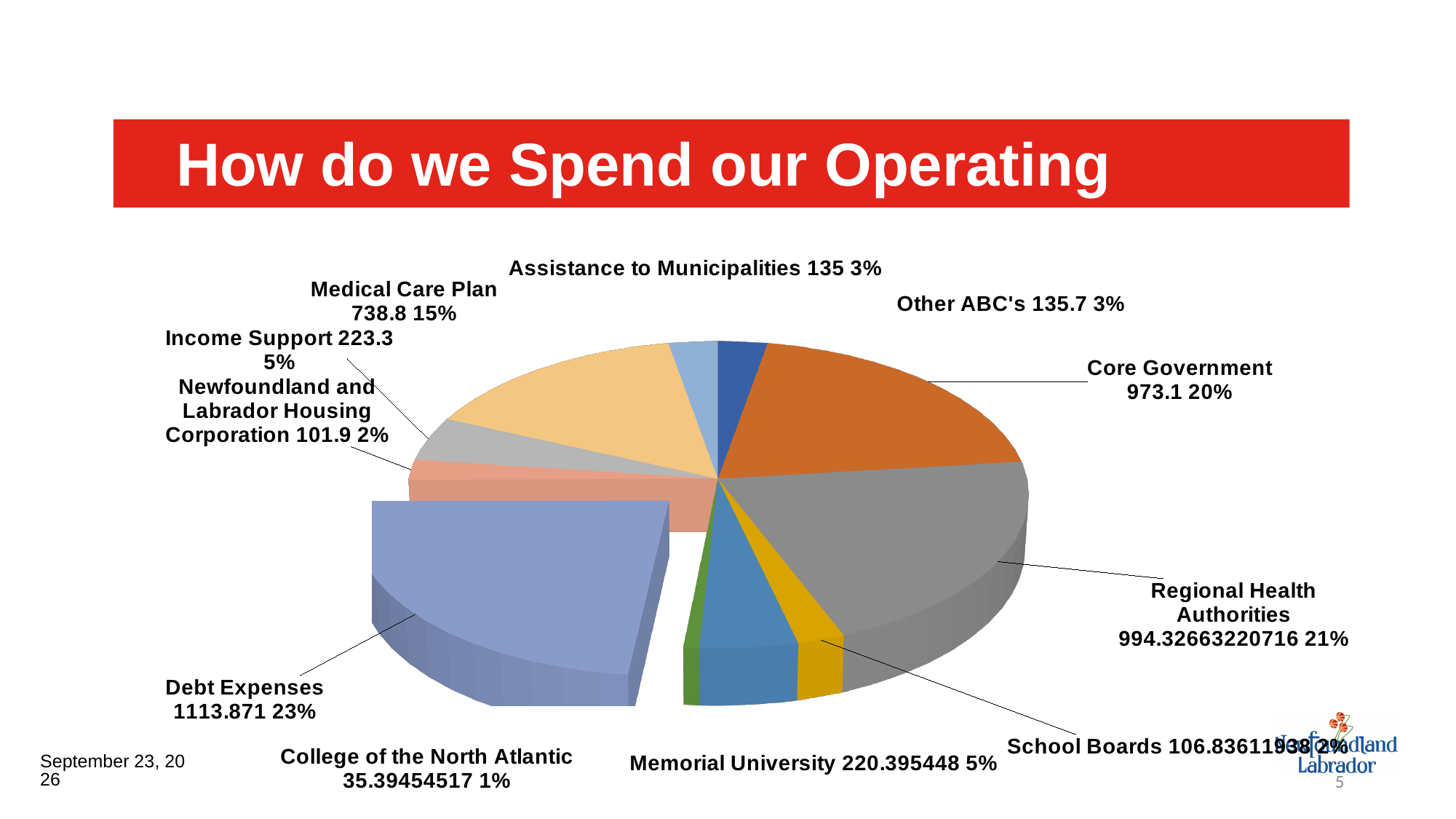
Which category has the largest slice of the pie chart? Debt Expenses What is the difference between the Debt Expenses value and the Core Government value? 140.771 Which category has the smallest slice of the pie chart? College of the North Atlantic What share of the pie does Medical Care Plan represent? 15% How many categories (slices) does the pie chart show? 11 What kind of chart is shown on the slide? pie chart What is the value shown for Income Support? 223.3 What share of the pie does Debt Expenses represent? 23% What is the title of the slide containing the pie chart? How do we Spend our Operating What is the difference between the Other ABC's value and the Assistance to Municipalities value? 0.7 Which is larger, Core Government or Regional Health Authorities? Regional Health Authorities What is the value shown for Core Government? 973.1